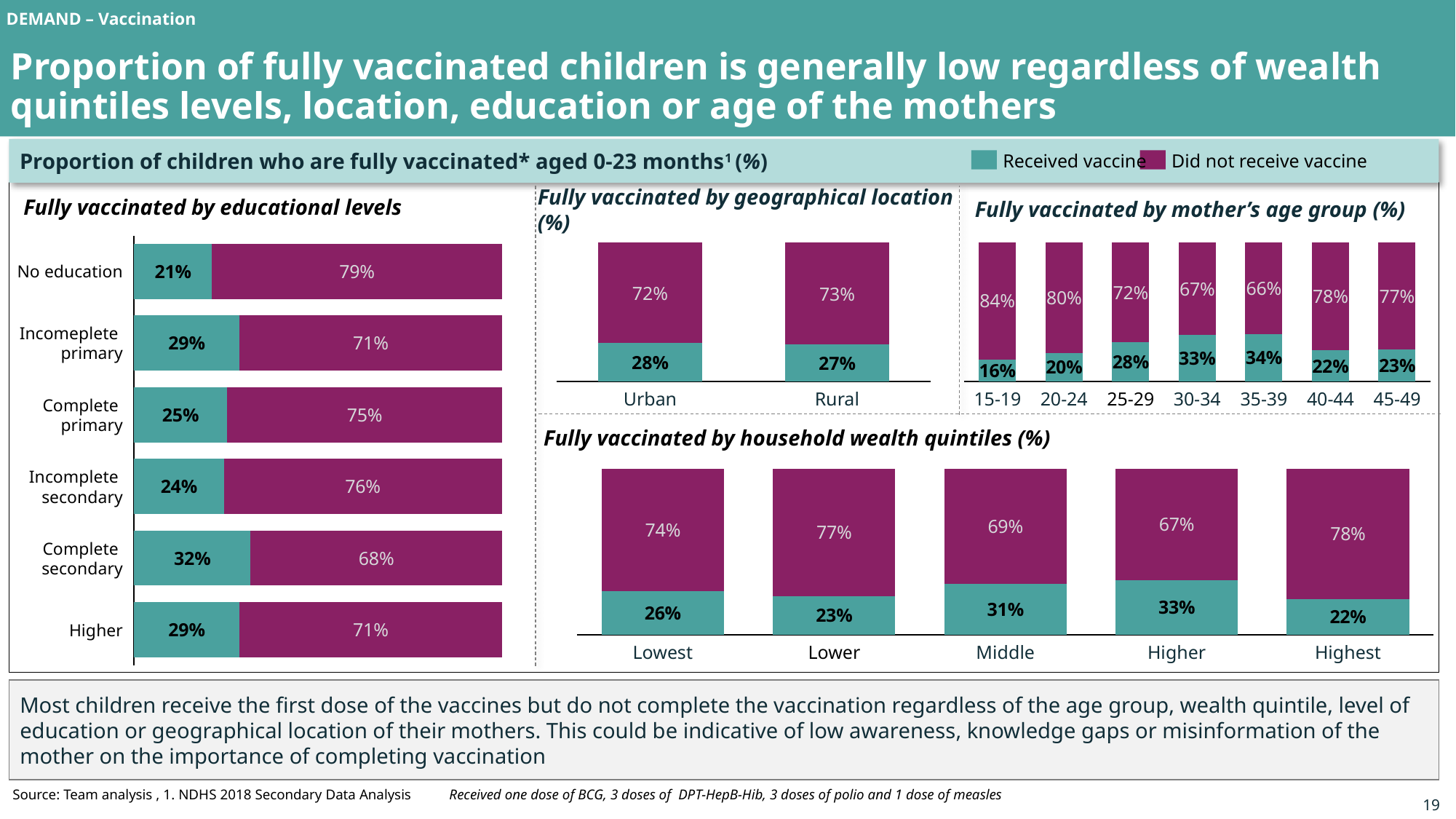
In the 'Fully vaccinated by household wealth quintiles' chart, what is the total of the two segments for the Lowest quintile bar? 100% In the 'Fully vaccinated by educational levels' chart, what percentage of children of mothers with no education received the vaccine? 21% In the 'Fully vaccinated by mother's age group' chart, how many age groups are shown? 7 In the 'Fully vaccinated by educational levels' chart, which educational level has the highest share of children who received the vaccine? Complete secondary In the 'Fully vaccinated by geographical location' chart, what is the difference between the urban and rural 'Received vaccine' percentages? 1% In the 'Fully vaccinated by household wealth quintiles' chart, which wealth quintile has the highest share of children who received the vaccine? Higher In the 'Fully vaccinated by educational levels' chart, how many educational level categories are shown? 6 How many series does the legend at the top of the slide list? 2 In the 'Fully vaccinated by mother's age group' chart, what percentage of children of mothers aged 35-39 received the vaccine? 34% In the 'Fully vaccinated by household wealth quintiles' chart, which is larger: the 'Received vaccine' share for the Middle quintile or for the Highest quintile? Middle In the 'Fully vaccinated by geographical location' chart, what percentage of rural children did not receive the vaccine? 73% In the 'Fully vaccinated by mother's age group' chart, which age group has the lowest share of children who received the vaccine? 15-19